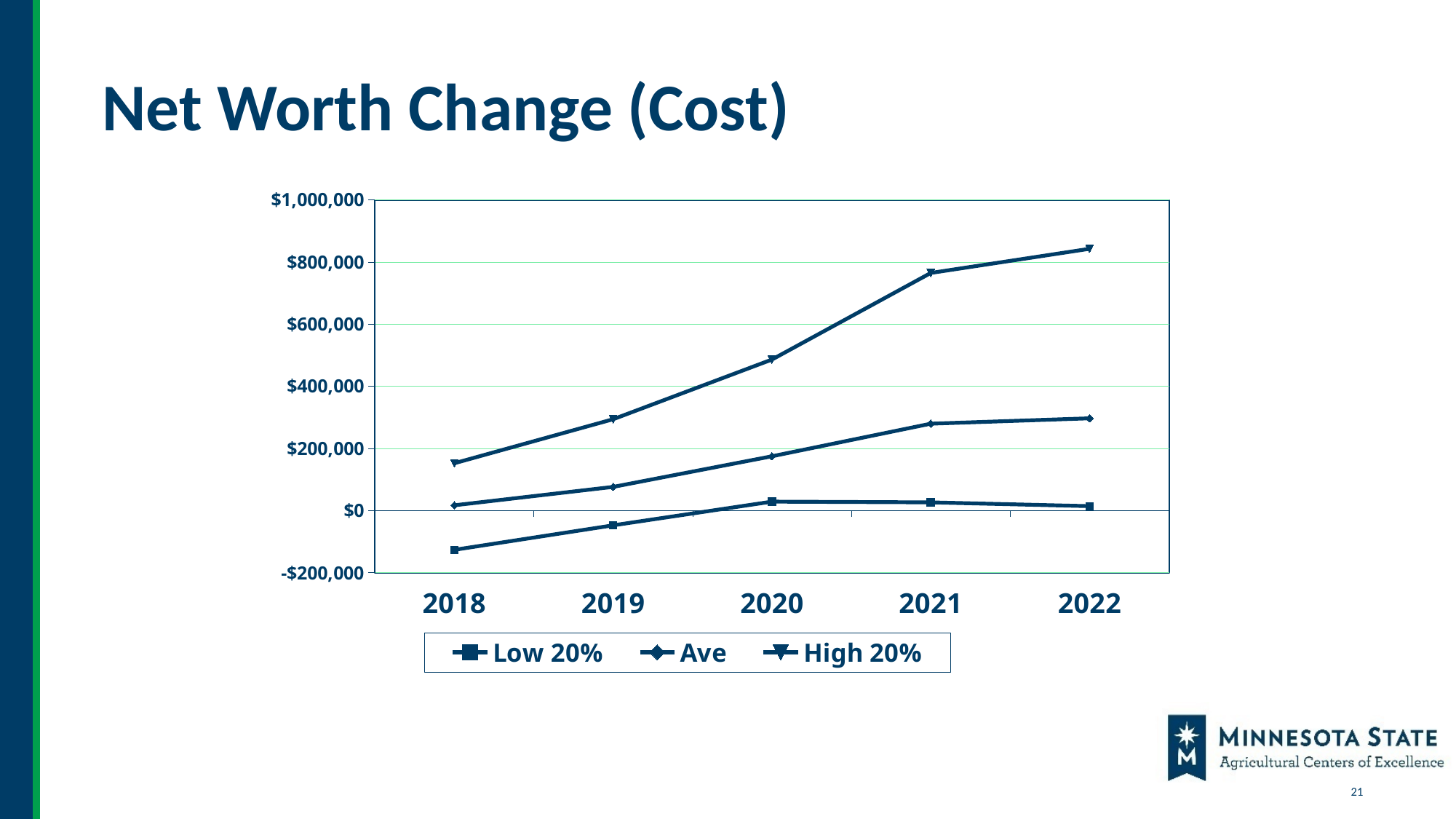
Which series are listed in the legend? Low 20%, Ave, High 20% Is the value for High 20% in 2022 greater or less than $800,000? greater In which year is the Low 20% series at its lowest? 2018 Is the value for Low 20% in 2018 greater or less than $0? less Is the value for High 20% in 2021 greater or less than $600,000? greater Which is larger in 2021, the High 20% value or the Ave value? High 20% What kind of chart is shown on the slide? line chart Does the High 20% series rise or fall from 2018 to 2022? rise How many series does the legend list? 3 How many years are plotted along the x axis? 5 In which year is the High 20% series at its highest? 2022